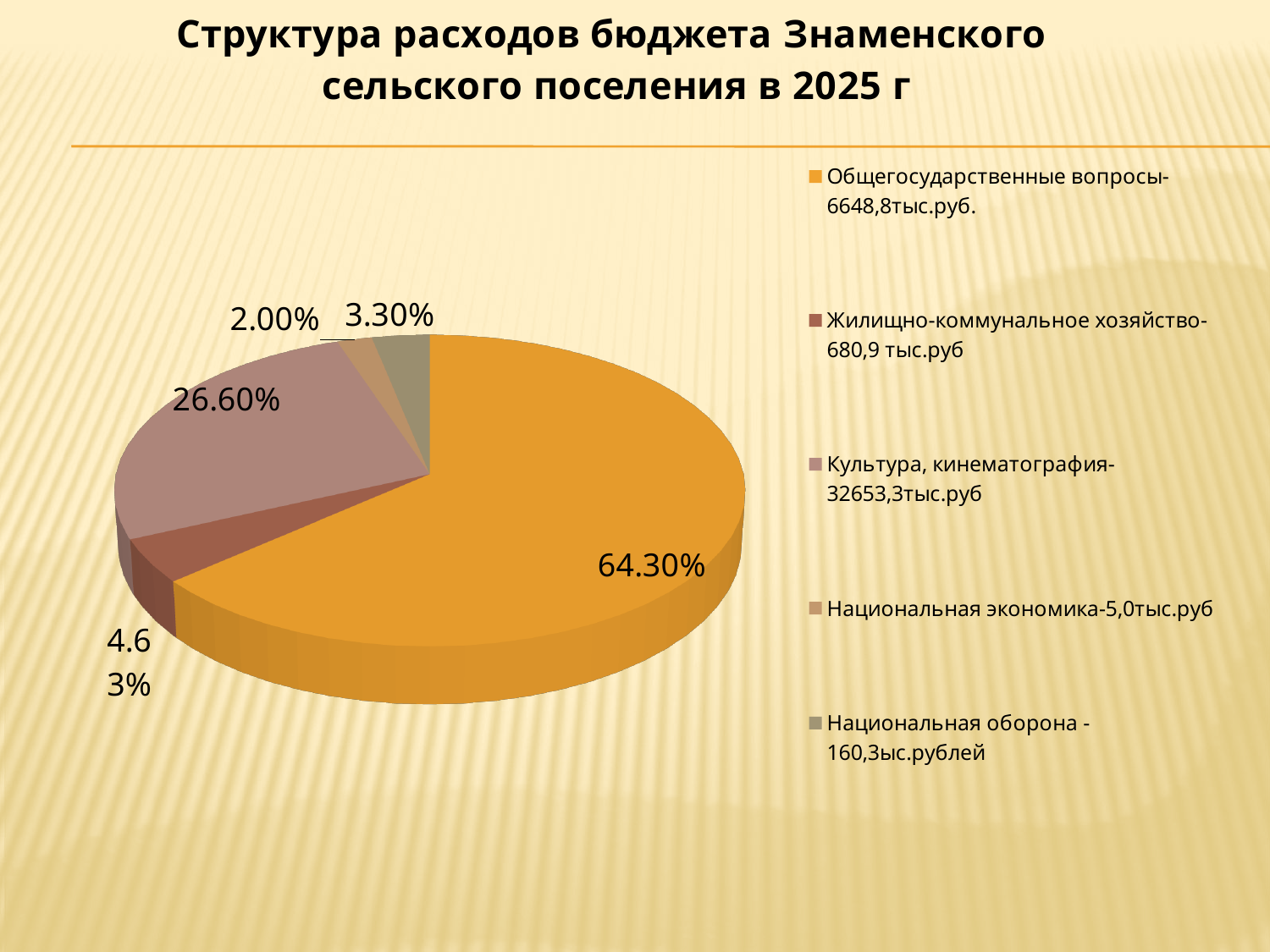
What percentage is shown for the Национальная экономика slice? 2.00% What percentage is shown for the Национальная оборона slice? 3.30% How many entries does the legend list? 5 What kind of chart is shown on the slide? pie chart Which category has the smallest share of the pie chart? Национальная экономика What is the difference in percentage points between the Общегосударственные вопросы slice and the Культура, кинематография slice? 37.70% What percentage is shown for the largest slice of the pie chart? 64.30% Which category has the largest share of the pie chart? Общегосударственные вопросы Which slice is larger: Национальная оборона or Национальная экономика? Национальная оборона What percentage is shown for the Культура, кинематография slice? 26.60% What is the title of the chart on the slide? Структура расходов бюджета Знаменского сельского поселения в 2025 г How many slices does the pie chart have? 5